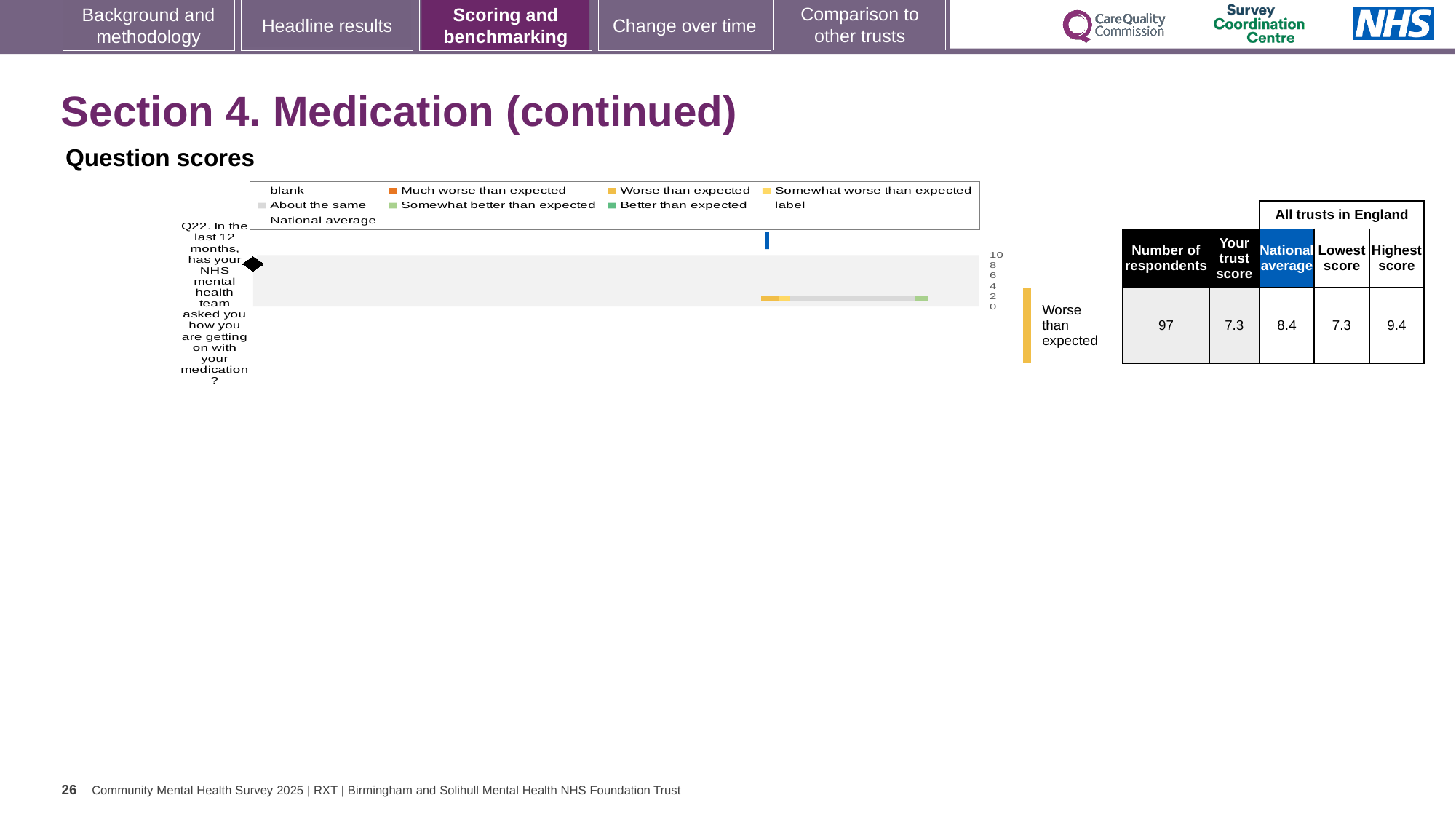
By how much does the national average exceed the trust's score for Q22? 1.1 How many respondents answered Q22? 97 What is the trust's score for Q22 according to the table? 7.3 What benchmark category is shown next to the chart for Q22? Worse than expected What is the maximum value shown on the chart's score axis? 10 Which is larger for Q22: the trust's score or the national average? National average What is the highest score among all trusts in England for Q22? 9.4 What kind of chart is used to show the Q22 question score? Bar chart What is the difference between the highest and lowest scores for Q22 across all trusts in England? 2.1 How many survey questions are plotted on the chart? 1 What is the national average score for Q22? 8.4 What is the lowest score among all trusts in England for Q22? 7.3